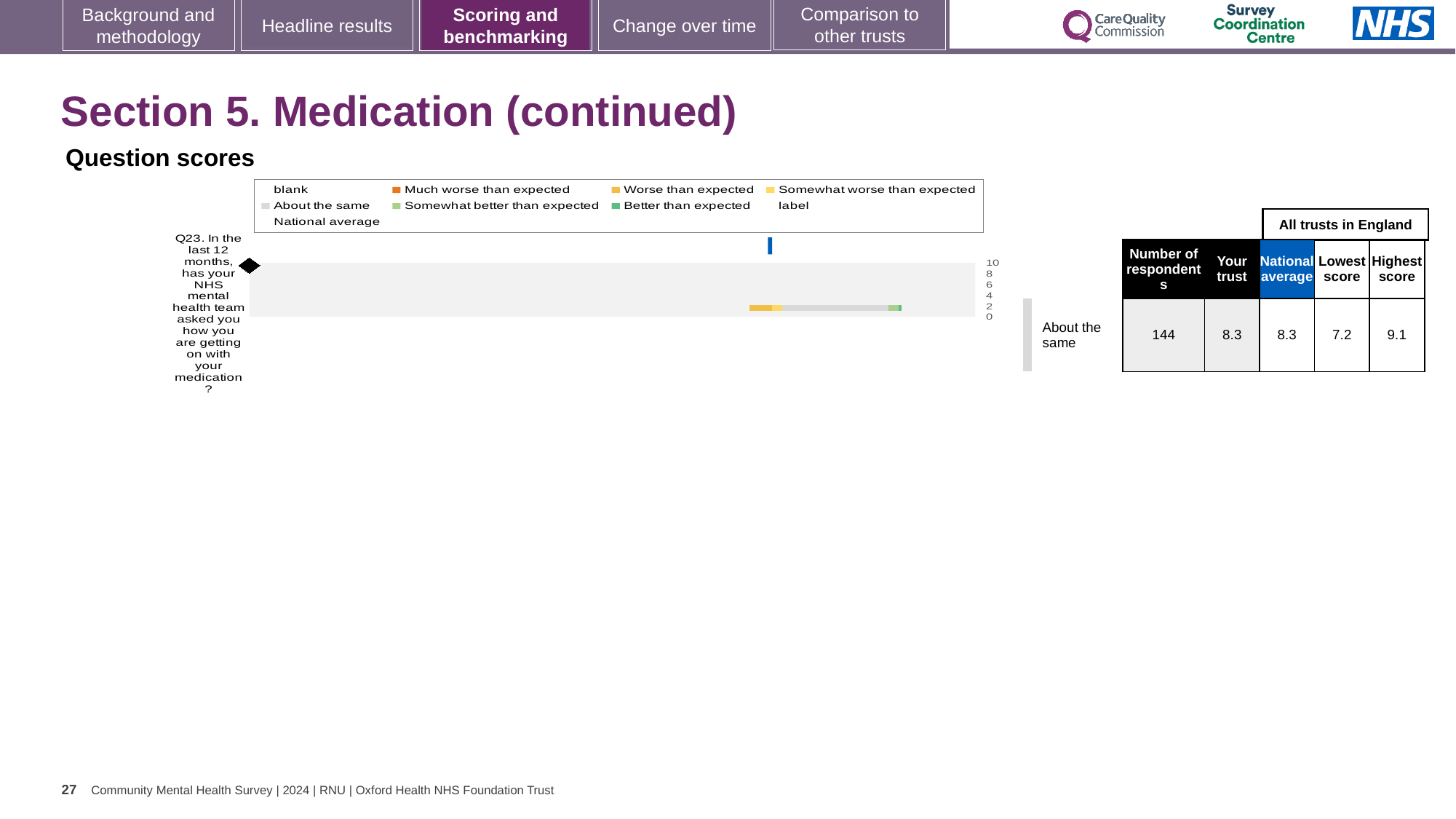
What benchmarking category label is shown for Q23 next to the chart? About the same What is the difference between the highest score and the lowest score for Q23? 1.9 Which of the two is larger for Q23: the highest score or the 'Your trust' score? Highest score How many survey questions are plotted in the chart? 1 What is the national average score for Q23 shown in the table beside the chart? 8.3 What kind of chart is shown under 'Question scores'? bar chart Which question number is plotted in the chart? Q23 What is the lowest score among all trusts in England for Q23? 7.2 What is the 'Your trust' score for Q23 in the table beside the chart? 8.3 What is the highest score among all trusts in England for Q23? 9.1 How many respondents answered Q23? 144